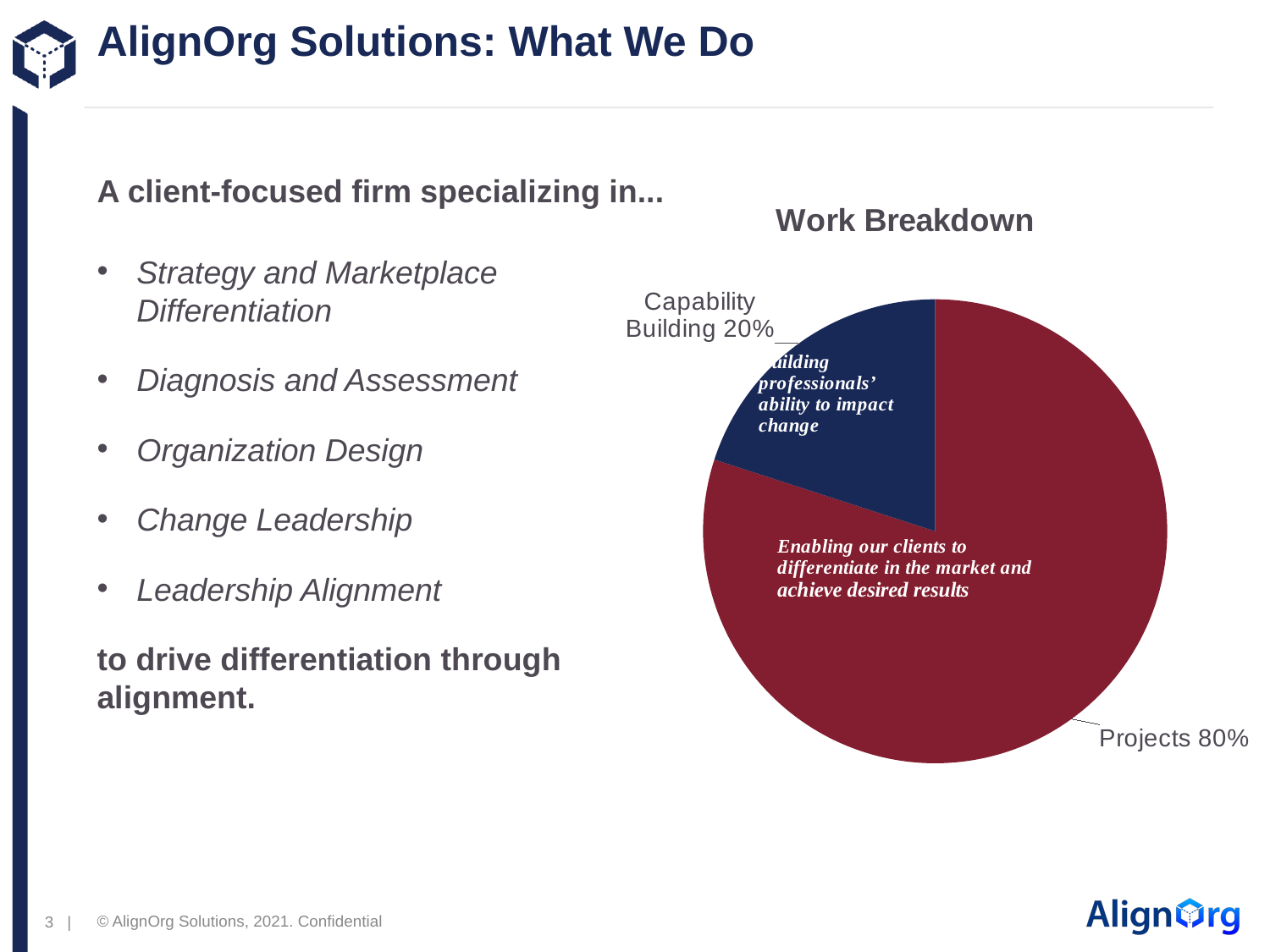
What share of the pie does Projects represent? 80% Which slice of the pie is the largest? Projects What share of the pie does Capability Building represent? 20% What colour is the Projects slice of the pie? dark red What is the difference in percentage points between the Projects slice and the Capability Building slice? 60 What type of chart is shown under the title "Work Breakdown"? pie chart Which is larger, the Projects slice or the Capability Building slice? Projects What is the total of the two slices shown in the pie chart? 100% How many slices does the pie chart have? 2 What is the title of the chart on the slide? Work Breakdown Which slice of the pie is the smallest? Capability Building